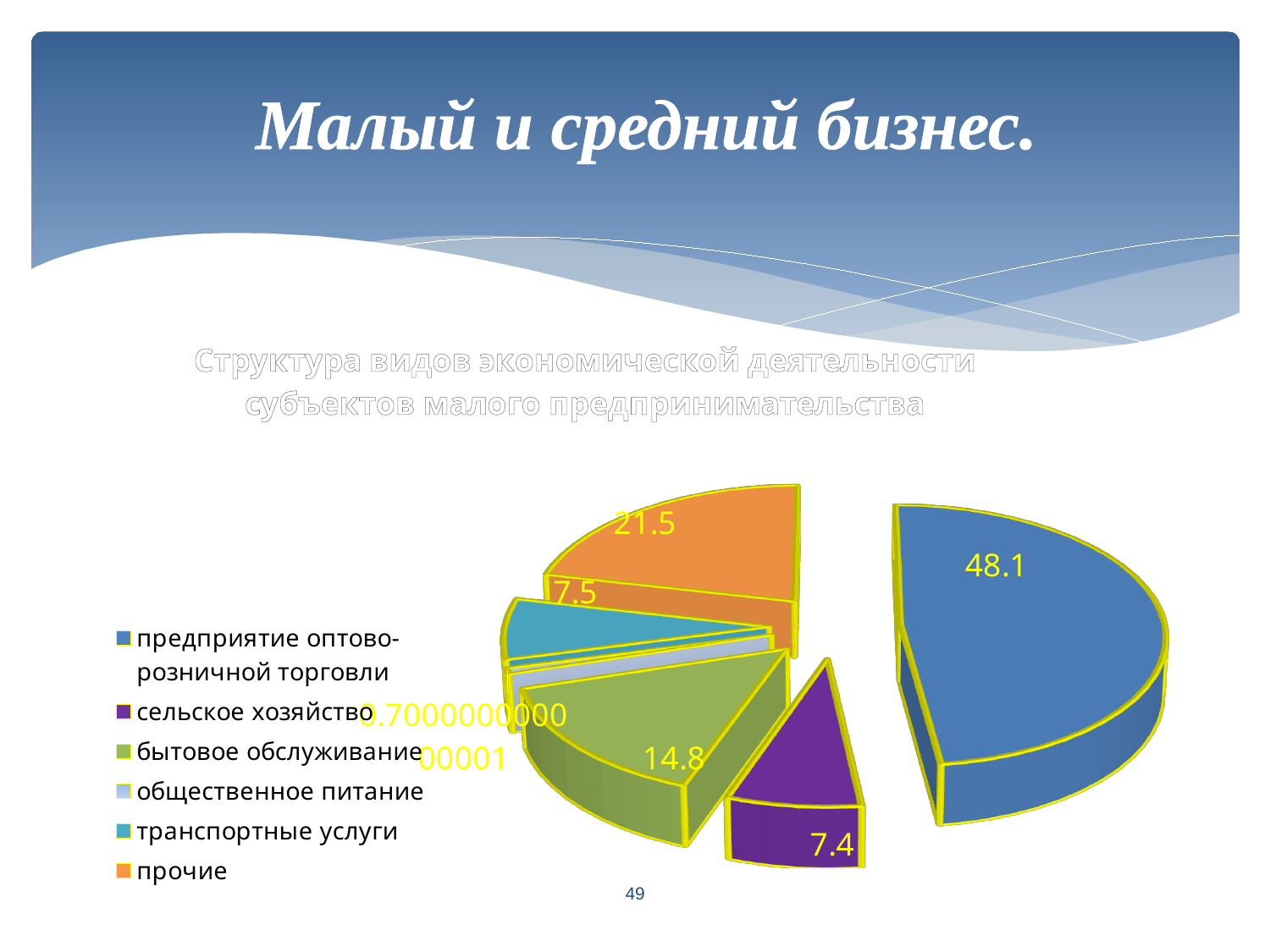
What is the value for прочие? 21.5 Which category has the largest slice of the pie? предприятие оптово-розничной торговли Which category has the smallest slice of the pie? общественное питание What is the value for сельское хозяйство? 7.4 How many categories does the pie chart show? 6 What kind of chart is shown on the slide? pie chart Which is larger, the value for прочие or the value for бытовое обслуживание? прочие What is the value for бытовое обслуживание? 14.8 What is the title of the chart? Структура видов экономической деятельности субъектов малого предпринимательства What is the difference between the values for предприятие оптово-розничной торговли and прочие? 26.6 What is the value for транспортные услуги? 7.5 What is the value for предприятие оптово-розничной торговли? 48.1